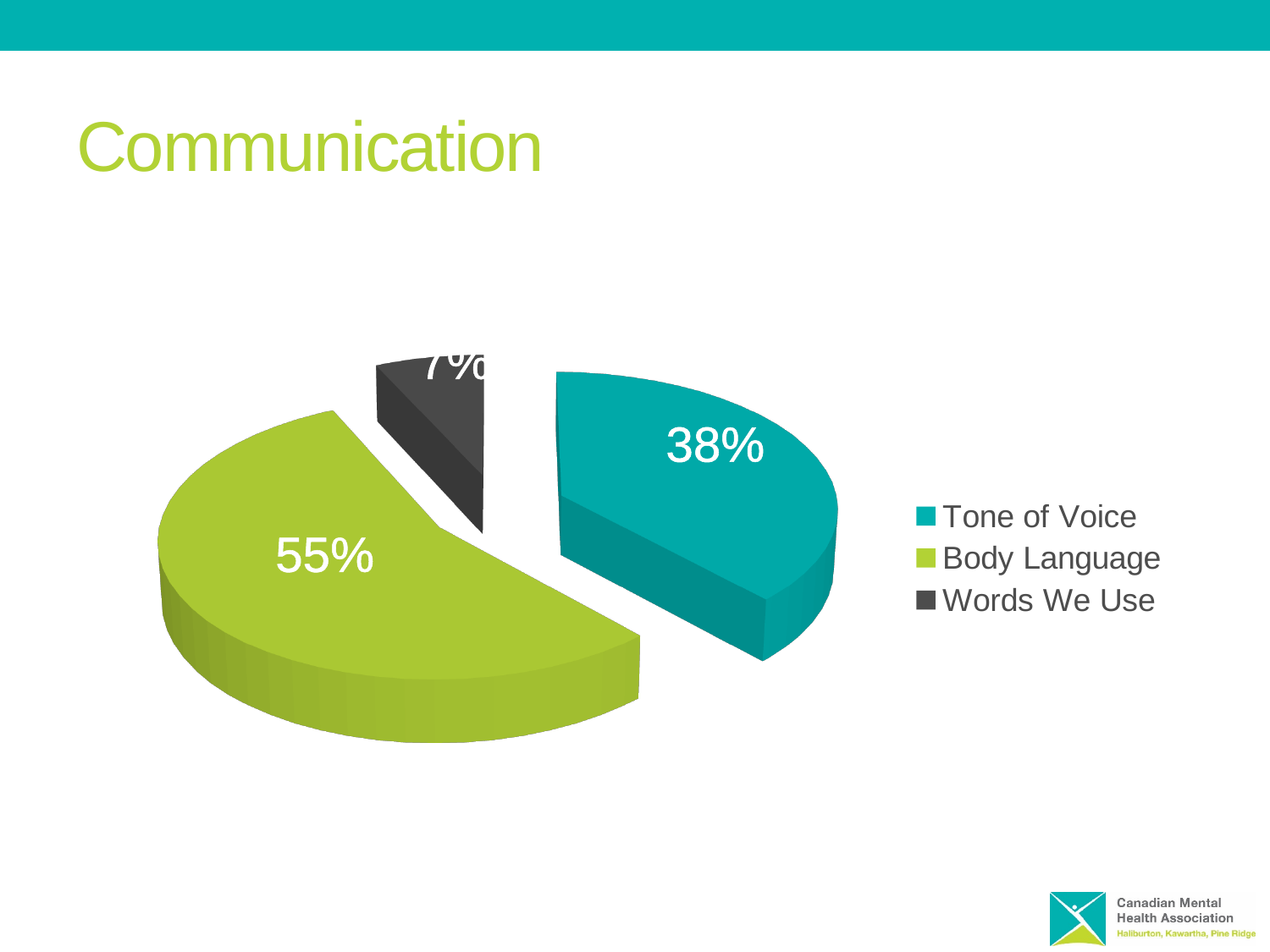
How many categories does the pie chart have? 3 What kind of chart is shown on the slide? pie chart What is the title of the slide containing the pie chart? Communication What percentage of the pie is Tone of Voice? 38% What is the difference between the Tone of Voice share and the Words We Use share? 31% Which category has the largest share of the pie? Body Language Which category has the smallest share of the pie? Words We Use What is the difference between the Body Language share and the Tone of Voice share? 17% What percentage of the pie is Words We Use? 7% What percentage of the pie is Body Language? 55% Which colour represents Tone of Voice in the legend? teal Which is larger, the share for Tone of Voice or the share for Body Language? Body Language